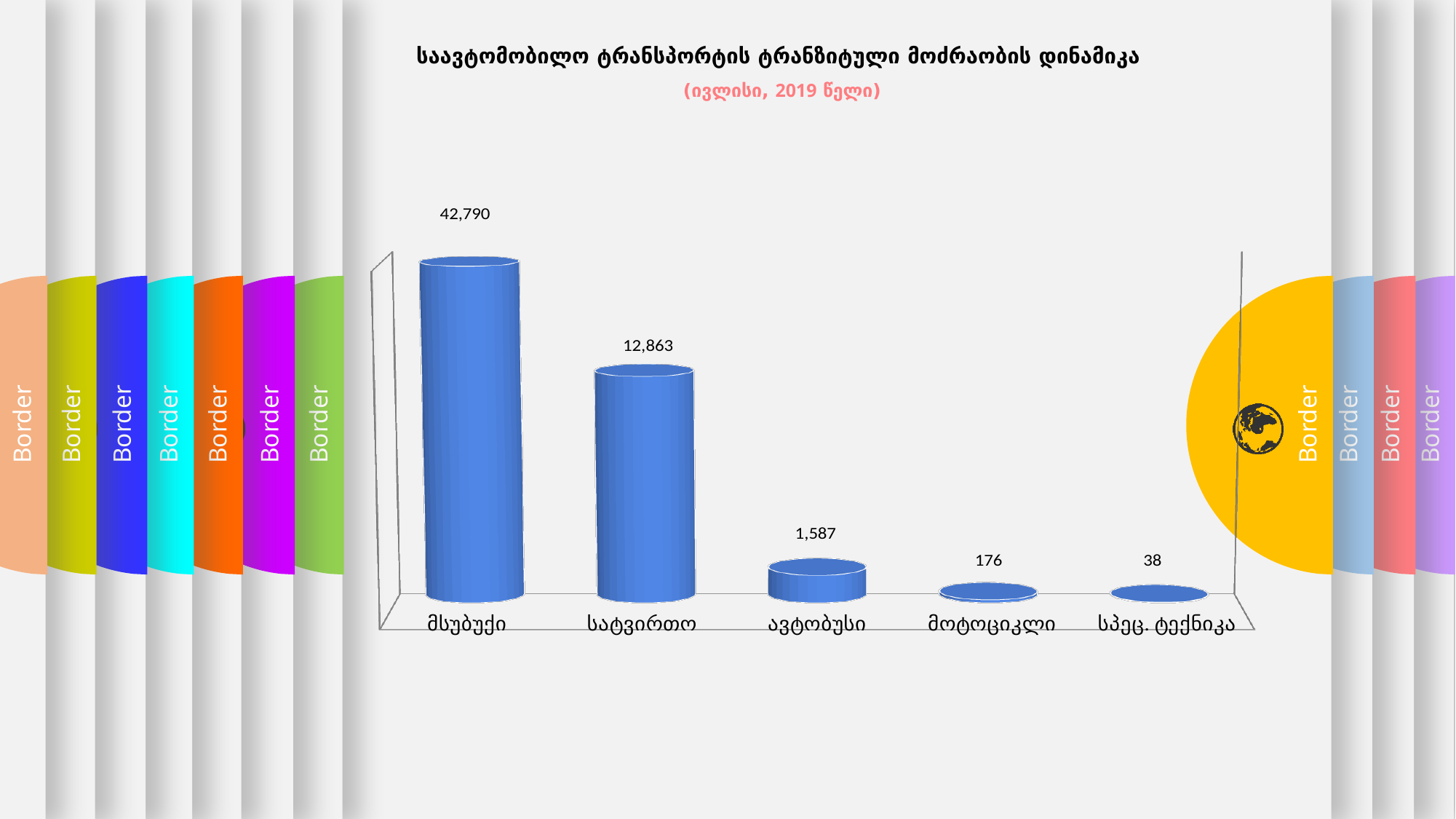
What is the value for ავტობუსი? 1,587 What is the difference between the values for მსუბუქი and სატვირთო? 29,927 Do the values rise or fall from left to right along the x axis? Fall Which is larger, the value for მოტოციკლი or the value for სპეც. ტექნიკა? მოტოციკლი What is the value for მოტოციკლი? 176 What is the value for სატვირთო? 12,863 What is the value for მსუბუქი? 42,790 What is the value for სპეც. ტექნიკა? 38 How many categories are shown in the chart? 5 Which category has the lowest value? სპეც. ტექნიკა Which category has the highest value? მსუბუქი What kind of chart is shown on the slide? Bar chart